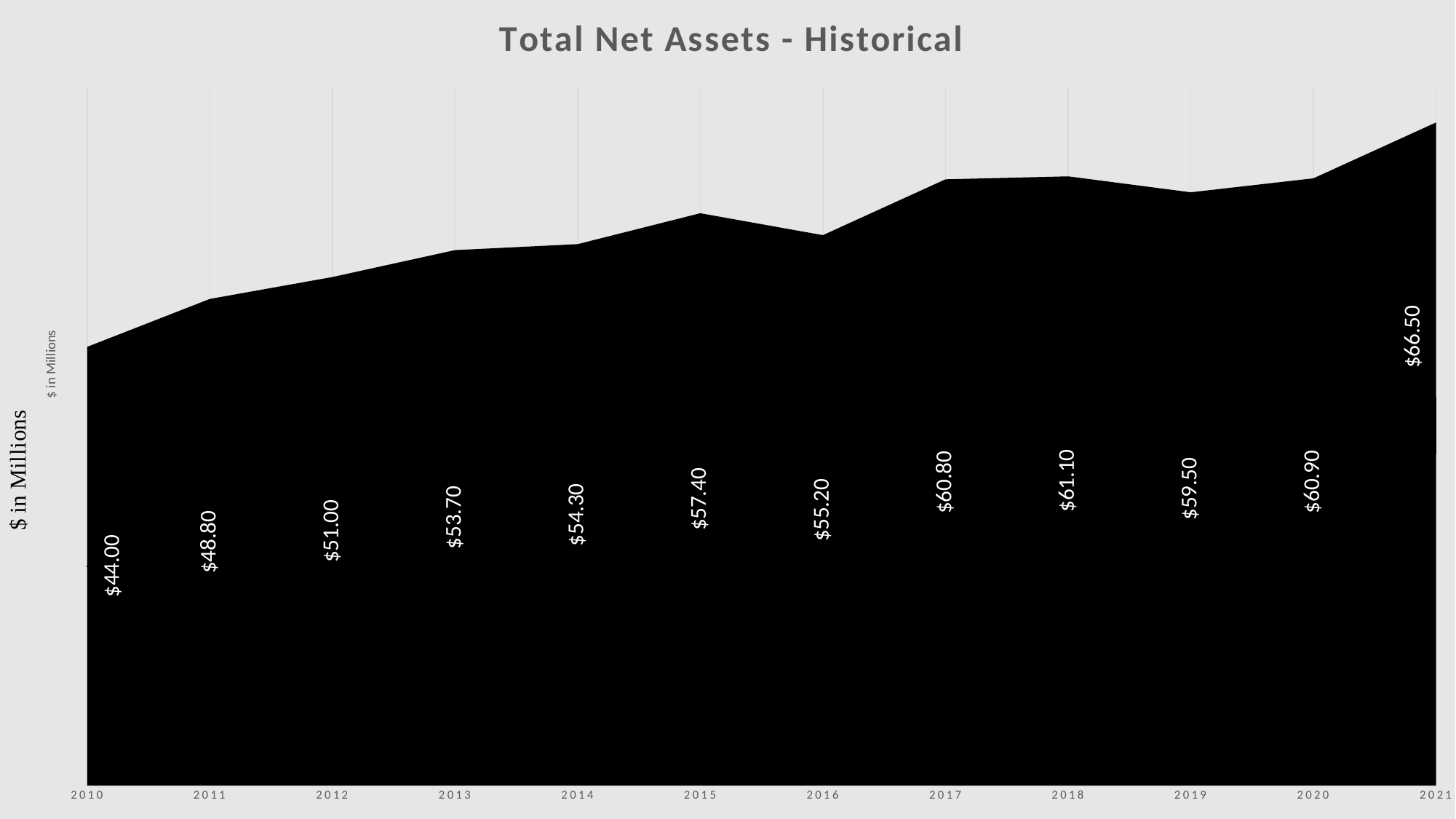
What kind of chart is this? area chart What is the difference between the values for 2015 and 2016? $2.20 Do the values generally rise or fall from 2010 to 2021? rise What is the value for 2016? $55.20 Which year has the highest total net assets? 2021 Which is larger, the value for 2018 or the value for 2019? 2018 What is the value for 2019? $59.50 What is the value for 2010? $44.00 What is the title of the chart? Total Net Assets - Historical Which year has the lowest total net assets? 2010 How many years are plotted on the chart? 12 What is the difference between the values for 2021 and 2020? $5.60